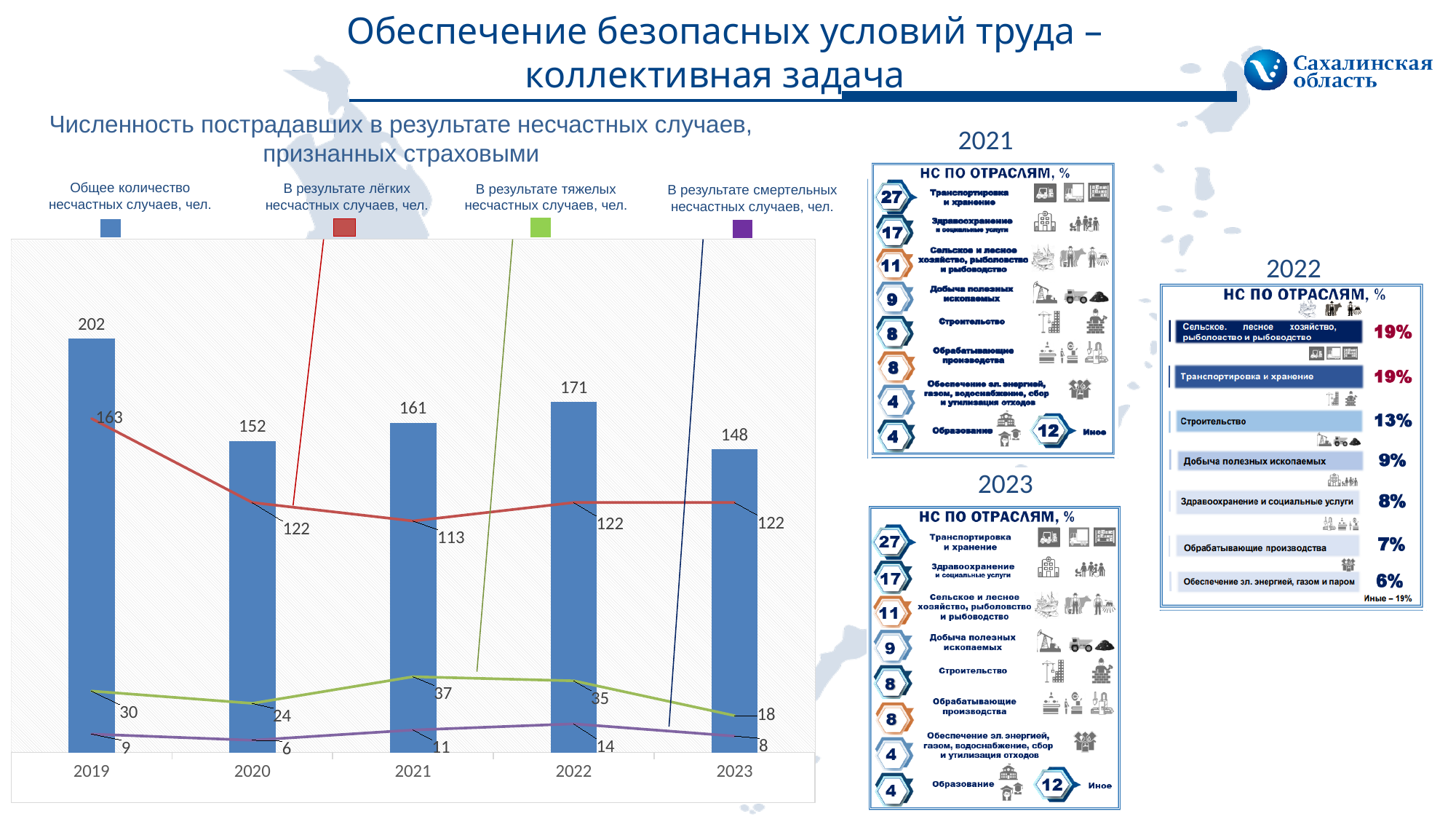
In which year is the total number of accidents (blue bars) the highest? 2019 What is the difference between the total number of accidents and the number of light accidents (лёгких) in 2023? 26 What is the value of the 'В результате смертельных несчастных случаев' series for 2022? 14 What is the value of the 'В результате лёгких несчастных случаев' series for 2021? 113 What is the value of the 'В результате тяжелых несчастных случаев' series for 2023? 18 What is the total number of accidents (Общее количество несчастных случаев) shown for 2019? 202 How many years are shown on the x axis of the chart? 5 Which is larger: the number of severe accidents (тяжелых) in 2021 or in 2020? 2021 How many series does the chart legend list? 4 In which year is the total number of accidents (blue bars) the lowest? 2023 What kind of chart is used for the 'Общее количество несчастных случаев' series? Bar chart By how much did the total number of accidents decrease from 2019 to 2020? 50